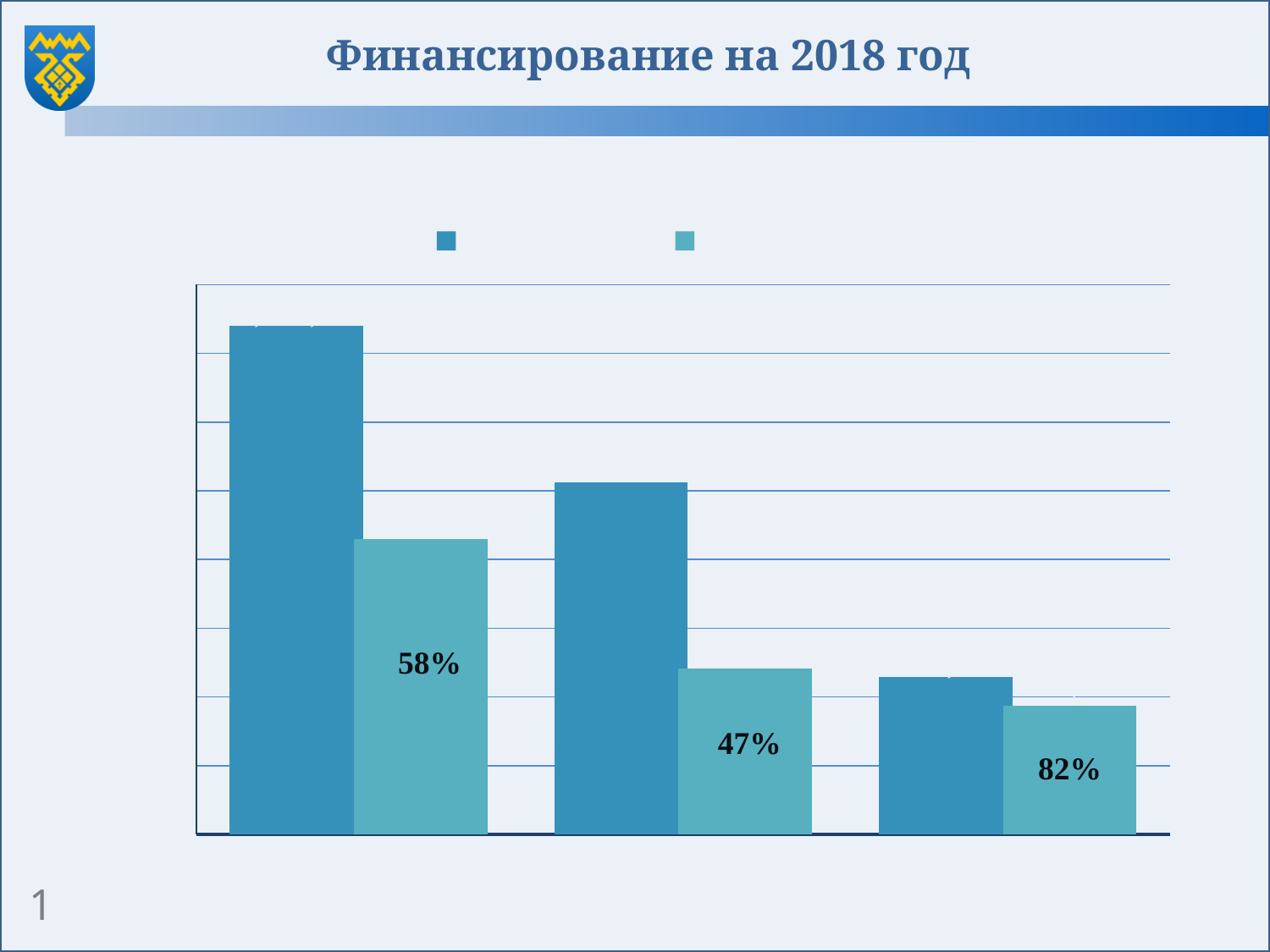
What percentage is labelled on the lighter bar of the first (leftmost) group? 58% What kind of chart is shown on the slide? bar chart How many series does the legend of the chart list? 2 What is the title of the chart on the slide? Финансирование на 2018 год Which group has the lowest percentage label on its lighter bar? the second (middle) group What percentage is labelled on the lighter bar of the third (rightmost) group? 82% Which group has the highest percentage label on its lighter bar? the third (rightmost) group Do the darker bars rise or fall from left to right across the chart? fall Which is larger: the percentage label of the first group or of the second group? the first group (58%) What percentage is labelled on the lighter bar of the second (middle) group? 47% How many groups of bars are plotted in the chart? 3 What is the difference between the percentage labels of the third group (82%) and the second group (47%)? 35 percentage points